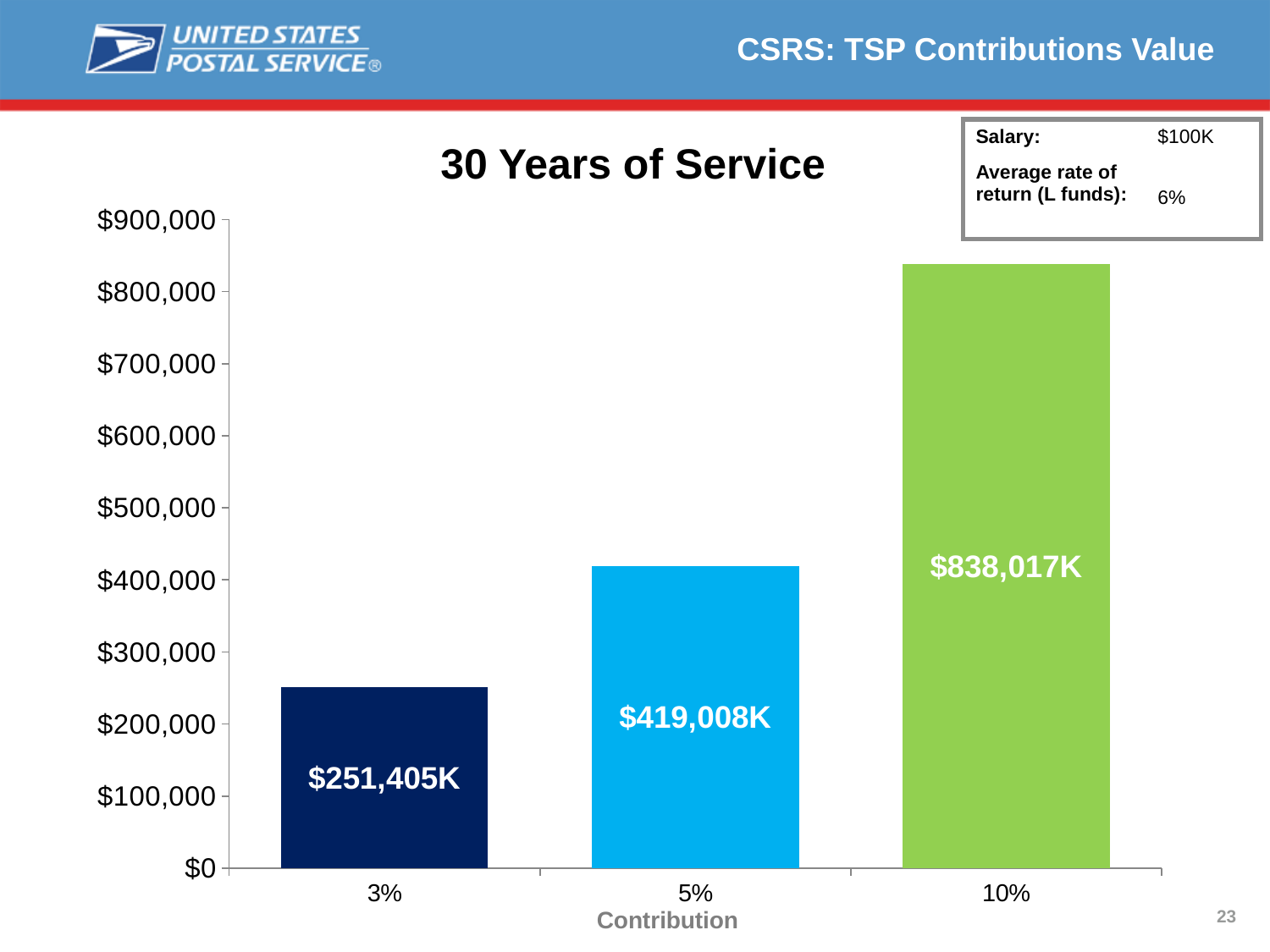
Which contribution rate has the highest value? 10% Is the value for the 10% contribution greater or less than $800,000? greater What kind of chart is shown on the slide? bar chart What is the difference between the values for the 5% and 3% contribution bars? $167,603K What is the value shown for the 3% contribution bar? $251,405K Do the values rise or fall as the contribution rate increases along the x axis? rise How many contribution rates are shown on the chart? 3 Which contribution rate has the lowest value? 3% What is the value shown for the 5% contribution bar? $419,008K What is the value shown for the 10% contribution bar? $838,017K Which is larger, the value for the 5% contribution or the 3% contribution? 5% What is the difference between the values for the 10% and 5% contribution bars? $419,009K